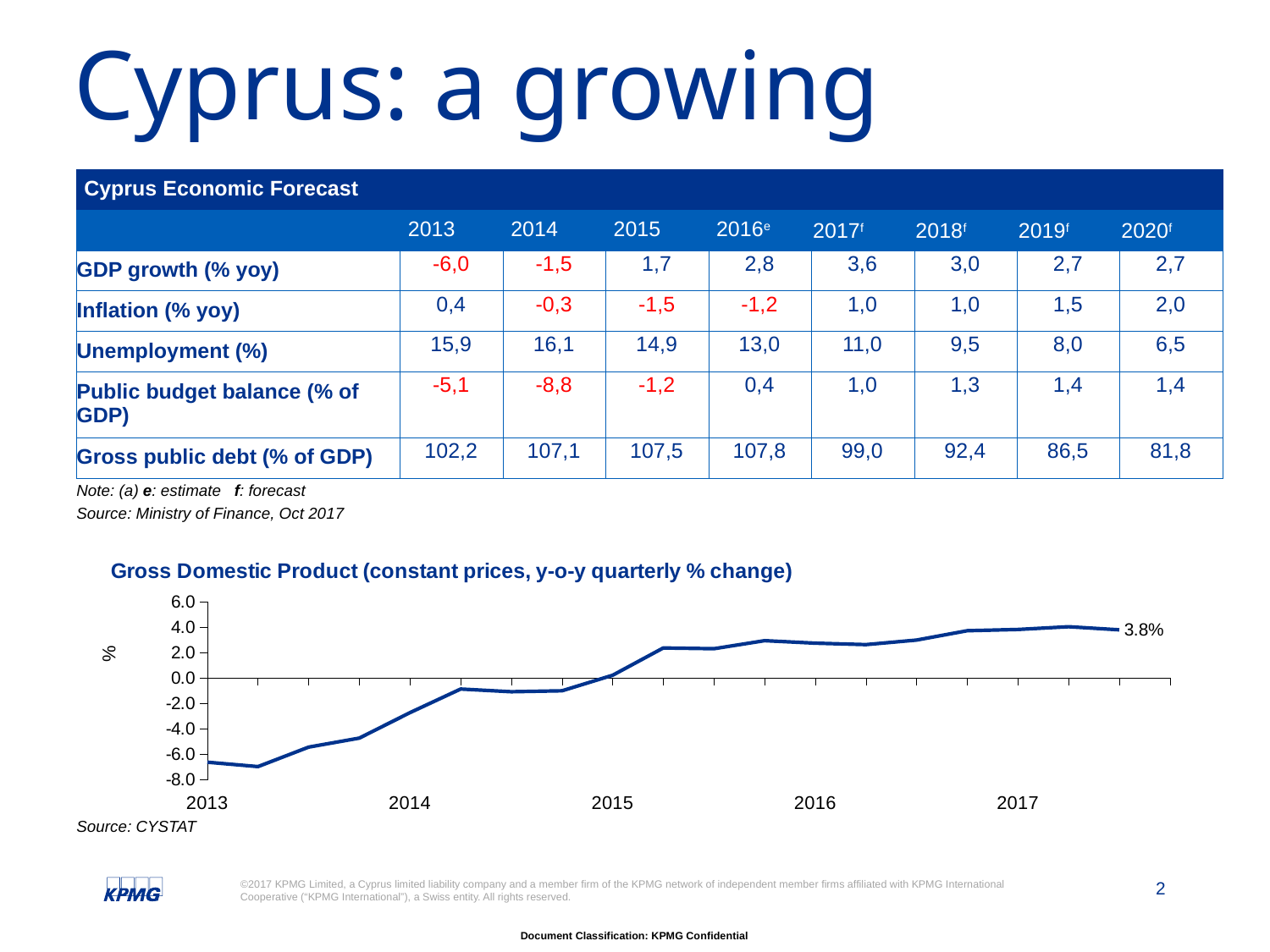
What is the title of the line chart on the slide? Gross Domestic Product (constant prices, y-o-y quarterly % change) What is the value shown by the data label at the end of the line in the Gross Domestic Product chart? 3.8% In the Gross Domestic Product chart, is the value at the start of 2014 greater or less than -2.0? less What kind of chart is the Gross Domestic Product chart at the bottom of the slide? line chart What is the highest tick value shown on the y axis of the Gross Domestic Product chart? 6.0 In the Gross Domestic Product chart, is the value at the start of 2013 greater or less than -4.0? less In the Gross Domestic Product chart, which is larger: the value at the start of 2013 or the value at the start of 2016? 2016 In the Gross Domestic Product chart, do the values generally rise or fall from 2013 to 2017? rise In the Gross Domestic Product chart, is the value at the start of 2017 greater or less than 2.0? greater What is the label on the y axis of the Gross Domestic Product chart? % In the Gross Domestic Product chart, in which year on the x axis does the line reach its lowest point? 2013